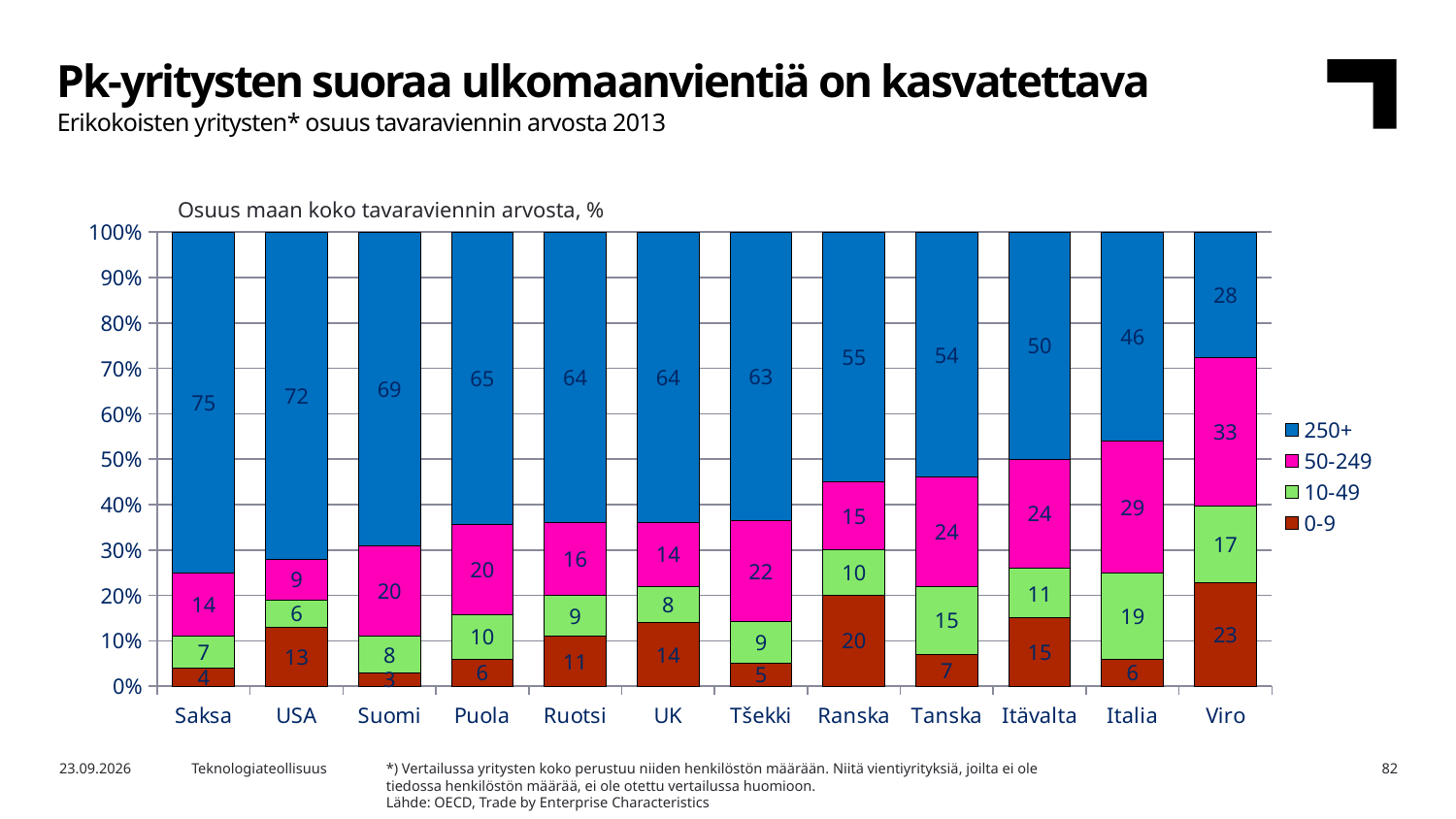
Which country has the lowest value for the 250+ series? Viro What is the value of the 0-9 series for Viro? 23 What kind of chart is shown on the slide? Stacked bar chart What is the value of the 50-249 series for Italia? 29 Do the values of the 250+ series rise or fall from Saksa to Viro along the x axis? Fall How many countries are shown on the x axis? 12 Which is larger, the 0-9 value for Ranska or the 0-9 value for Suomi? Ranska What is the value of the 10-49 series for Tanska? 15 What is the difference between the 250+ values for Saksa and Viro? 47 Which country has the highest value for the 50-249 series? Viro How many series does the legend list? 4 What is the value of the 250+ series for Saksa? 75